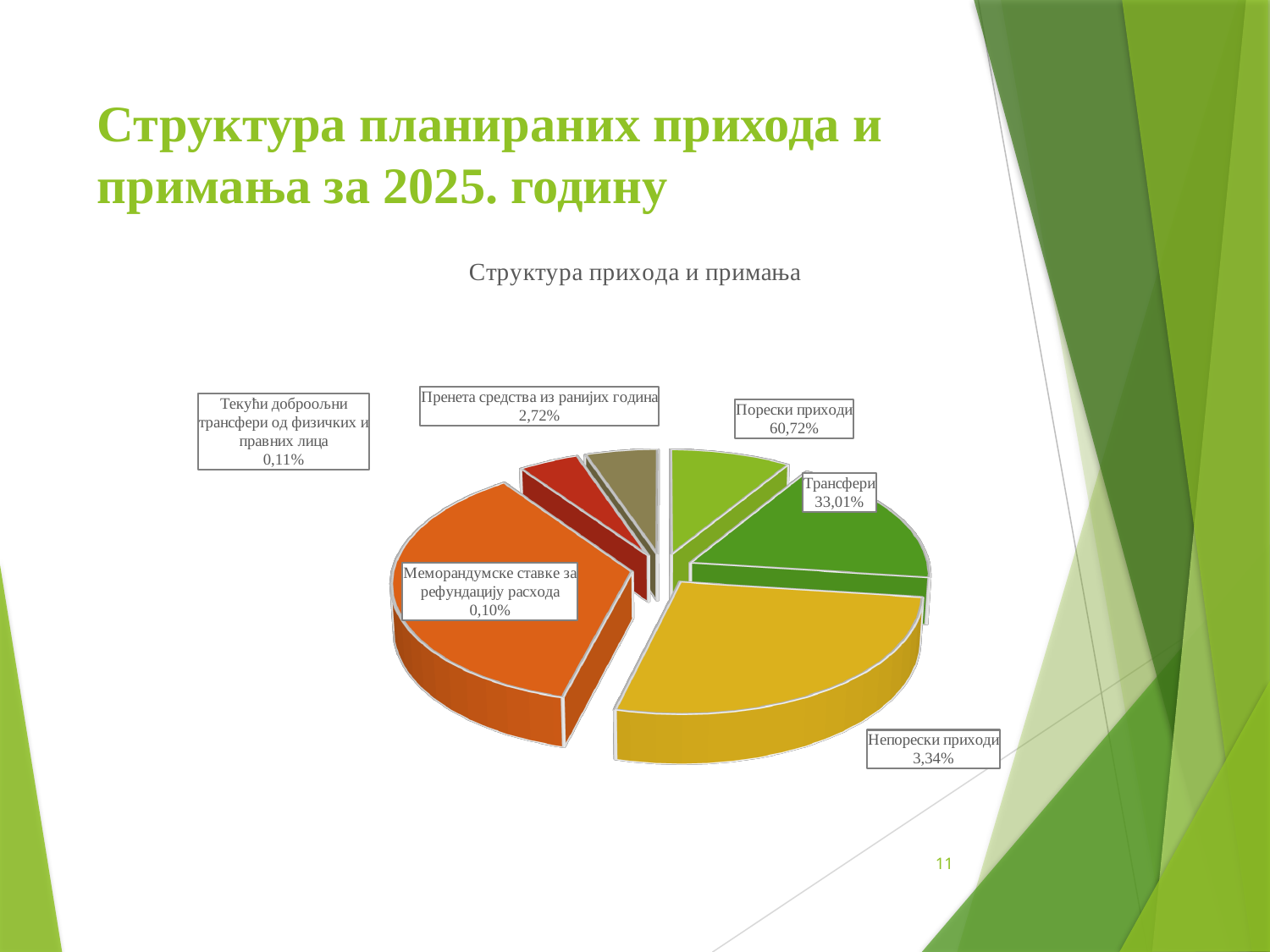
What is the difference between the shares of Порески приходи and Трансфери? 27,71% What is the value for Текући добровољни трансфери од физичких и правних лица? 0,11% What is the value for Меморандумске ставке за рефундацију расхода? 0,10% How many categories are shown in the pie chart? 6 What share of the pie is Порески приходи? 60,72% What is the value for Непорески приходи? 3,34% What is the value for Пренета средства из ранијих година? 2,72% Which is larger, Непорески приходи or Пренета средства из ранијих година? Непорески приходи What is the value for Трансфери? 33,01% What kind of chart is shown on the slide? pie chart What is the title of the chart? Структура прихода и примања Which category has the largest share of the pie? Порески приходи